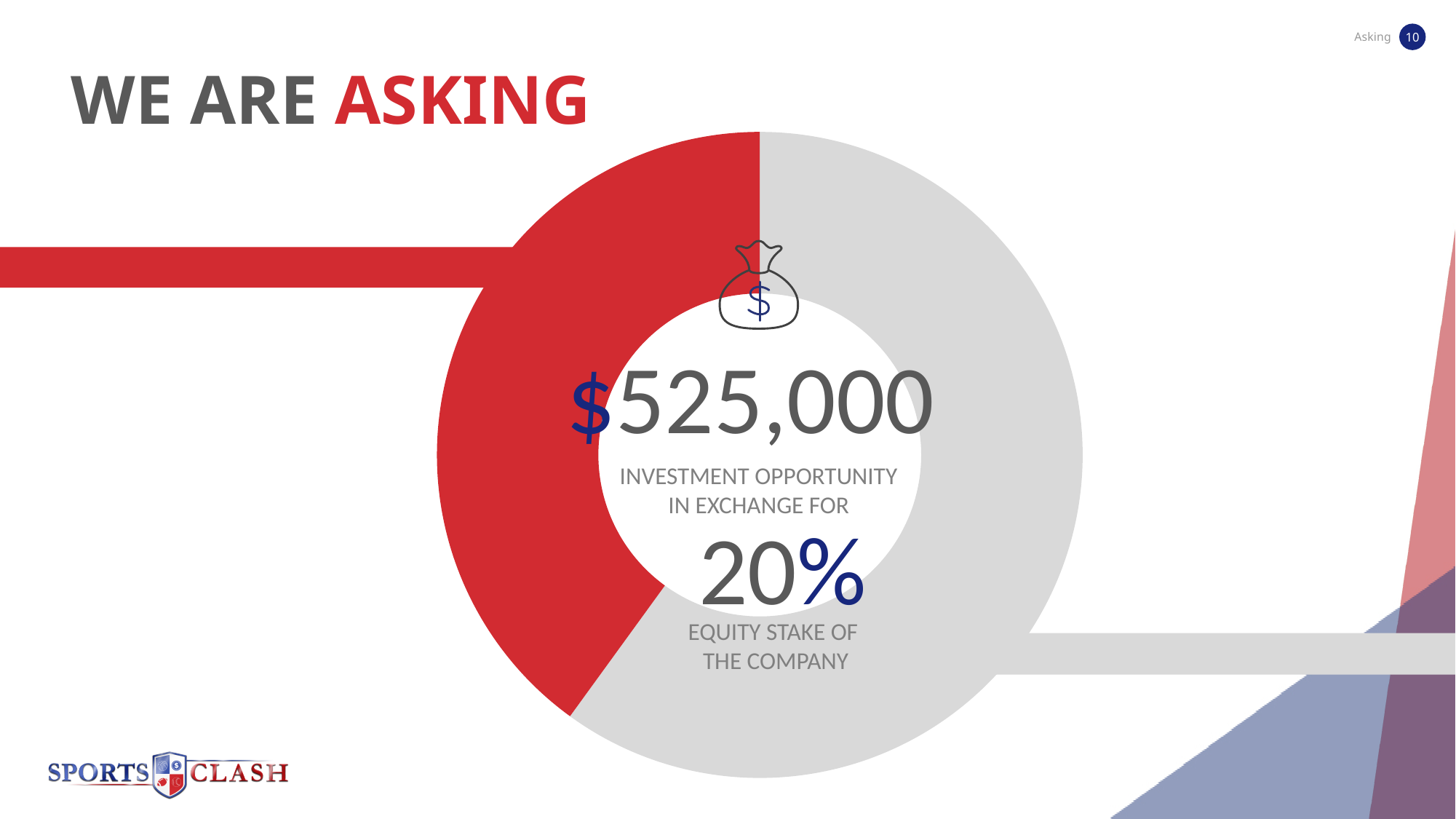
Which segment of the donut chart is larger, the red one or the grey one? Grey What kind of chart is shown on the slide? Donut chart What two colours are used for the segments of the donut chart? Red and grey What equity stake percentage is printed in the centre of the donut chart? 20% What icon appears above the investment amount in the centre of the donut chart? A money bag How many segments does the donut chart have? 2 What investment amount is printed in the centre of the donut chart? $525,000